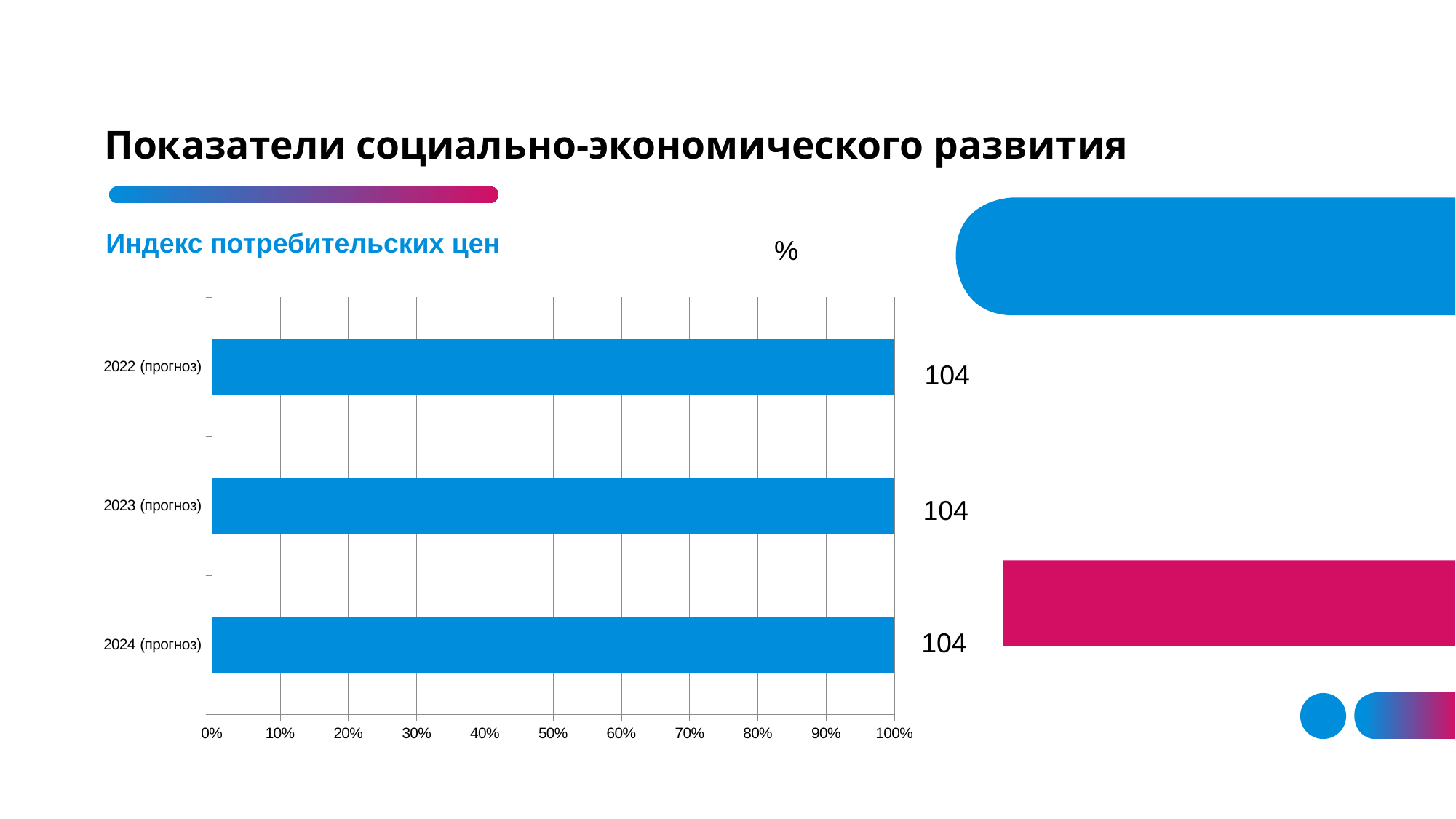
What is the highest tick value shown on the horizontal axis of the Индекс потребительских цен chart? 100% What kind of chart is used for Индекс потребительских цен? Bar chart What is the data label shown for 2022 (прогноз) in the Индекс потребительских цен chart? 104 What is the title of the chart on the slide? Индекс потребительских цен Do the labelled values in the Индекс потребительских цен chart rise, fall, or stay the same from 2022 (прогноз) to 2024 (прогноз)? Stay the same What is the data label shown for 2023 (прогноз) in the Индекс потребительских цен chart? 104 How many categories (years) are plotted in the Индекс потребительских цен chart? 3 What is the data label shown for 2024 (прогноз) in the Индекс потребительских цен chart? 104 What is the difference between the labelled values for 2022 (прогноз) and 2024 (прогноз) in the Индекс потребительских цен chart? 0 Which category is listed first (at the top) in the Индекс потребительских цен chart? 2022 (прогноз)